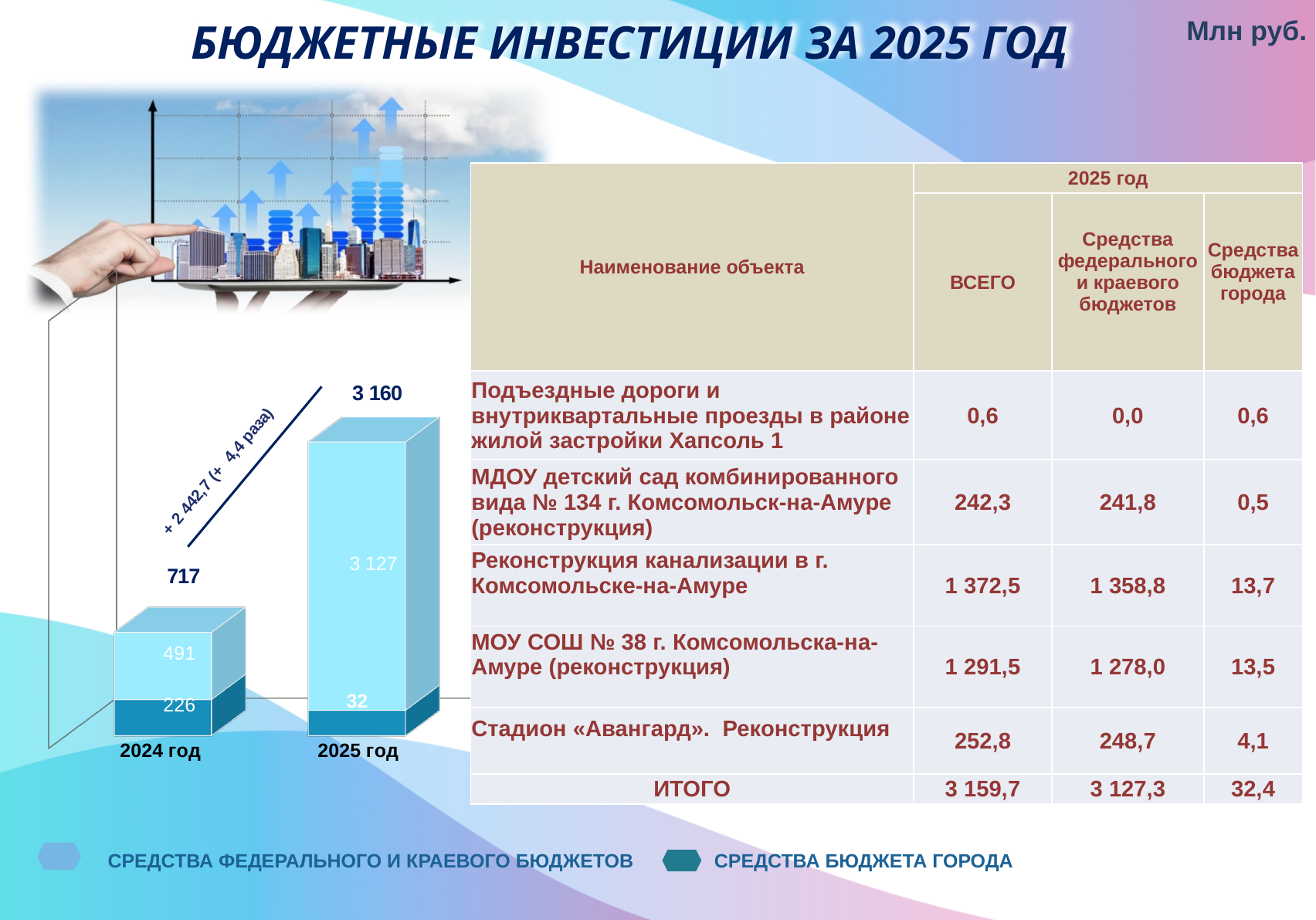
What is the value of СРЕДСТВА БЮДЖЕТА ГОРОДА for 2025 год? 32 What is the value of СРЕДСТВА БЮДЖЕТА ГОРОДА for 2024 год? 226 What is the total value of the stacked bar for 2024 год? 717 How many series does the chart legend list? 2 What is the value of СРЕДСТВА ФЕДЕРАЛЬНОГО И КРАЕВОГО БЮДЖЕТОВ for 2024 год? 491 What is the difference between the СРЕДСТВА БЮДЖЕТА ГОРОДА values for 2024 год and 2025 год? 194 How many categories (years) are shown on the bar chart? 2 What type of chart is shown on the left of the slide? stacked bar chart What is the value of СРЕДСТВА ФЕДЕРАЛЬНОГО И КРАЕВОГО БЮДЖЕТОВ for 2025 год? 3 127 Which year has the higher total budget investment on the chart? 2025 год What is the total value of the stacked bar for 2025 год? 3 160 Do total budget investments rise or fall from 2024 год to 2025 год? rise